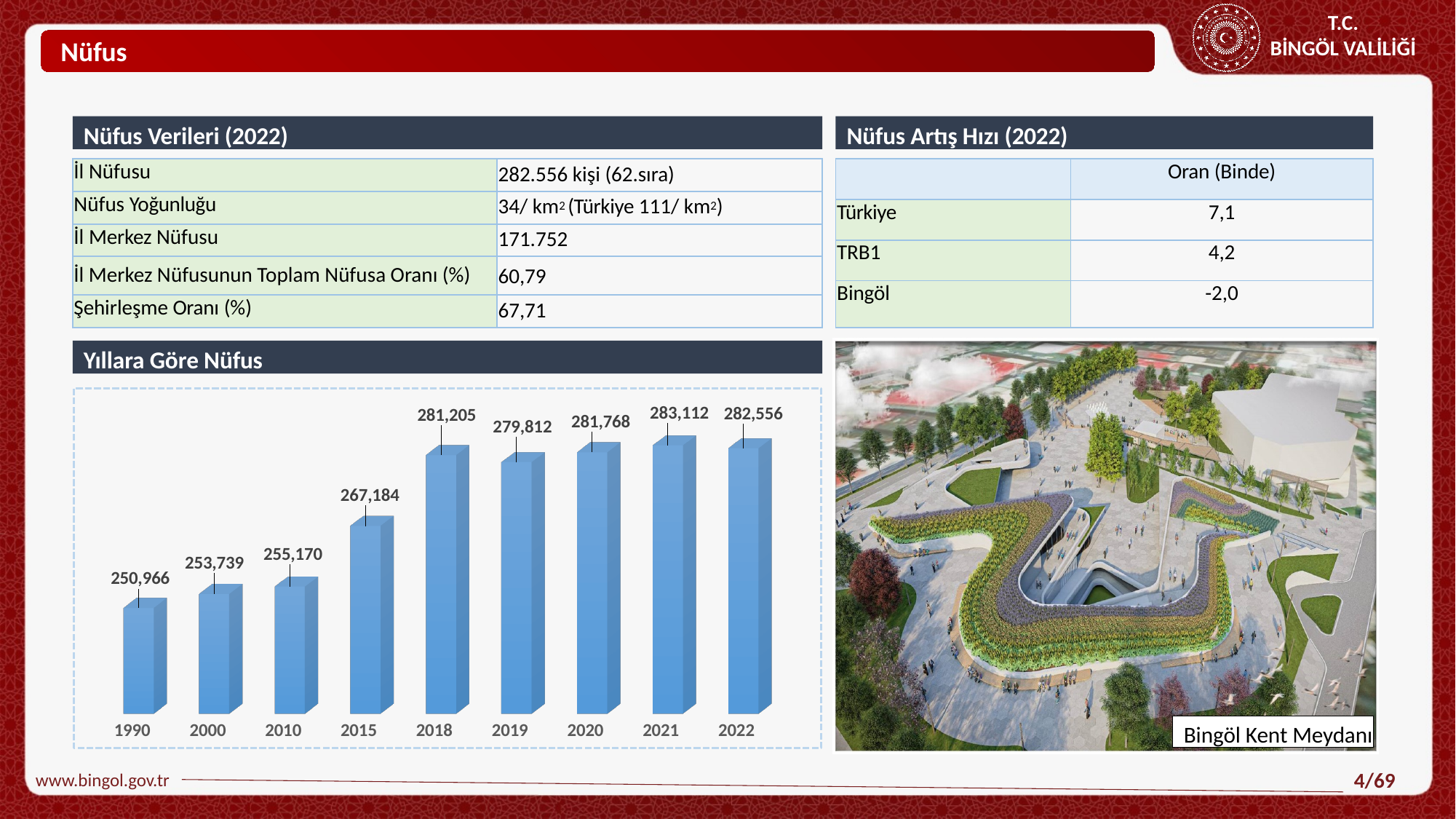
What is the population value shown for 1990 in the 'Yıllara Göre Nüfus' chart? 250,966 In the 'Yıllara Göre Nüfus' chart, does the population generally rise or fall from 1990 to 2022? Rise How many years are shown in the 'Yıllara Göre Nüfus' chart? 9 What type of chart is 'Yıllara Göre Nüfus'? Bar chart In the 'Yıllara Göre Nüfus' chart, how much higher is the 2022 value than the 1990 value? 31,590 In the 'Yıllara Göre Nüfus' chart, which year has the larger value, 2019 or 2020? 2020 In the 'Yıllara Göre Nüfus' chart, what is the difference between the 2021 and 2022 values? 556 What is the population value shown for 2015 in the 'Yıllara Göre Nüfus' chart? 267,184 Which year has the lowest population in the 'Yıllara Göre Nüfus' chart? 1990 Which year has the highest population in the 'Yıllara Göre Nüfus' chart? 2021 In the 'Yıllara Göre Nüfus' chart, what is the difference between the 2018 and 2019 values? 1,393 What is the population value shown for 2022 in the 'Yıllara Göre Nüfus' chart? 282,556